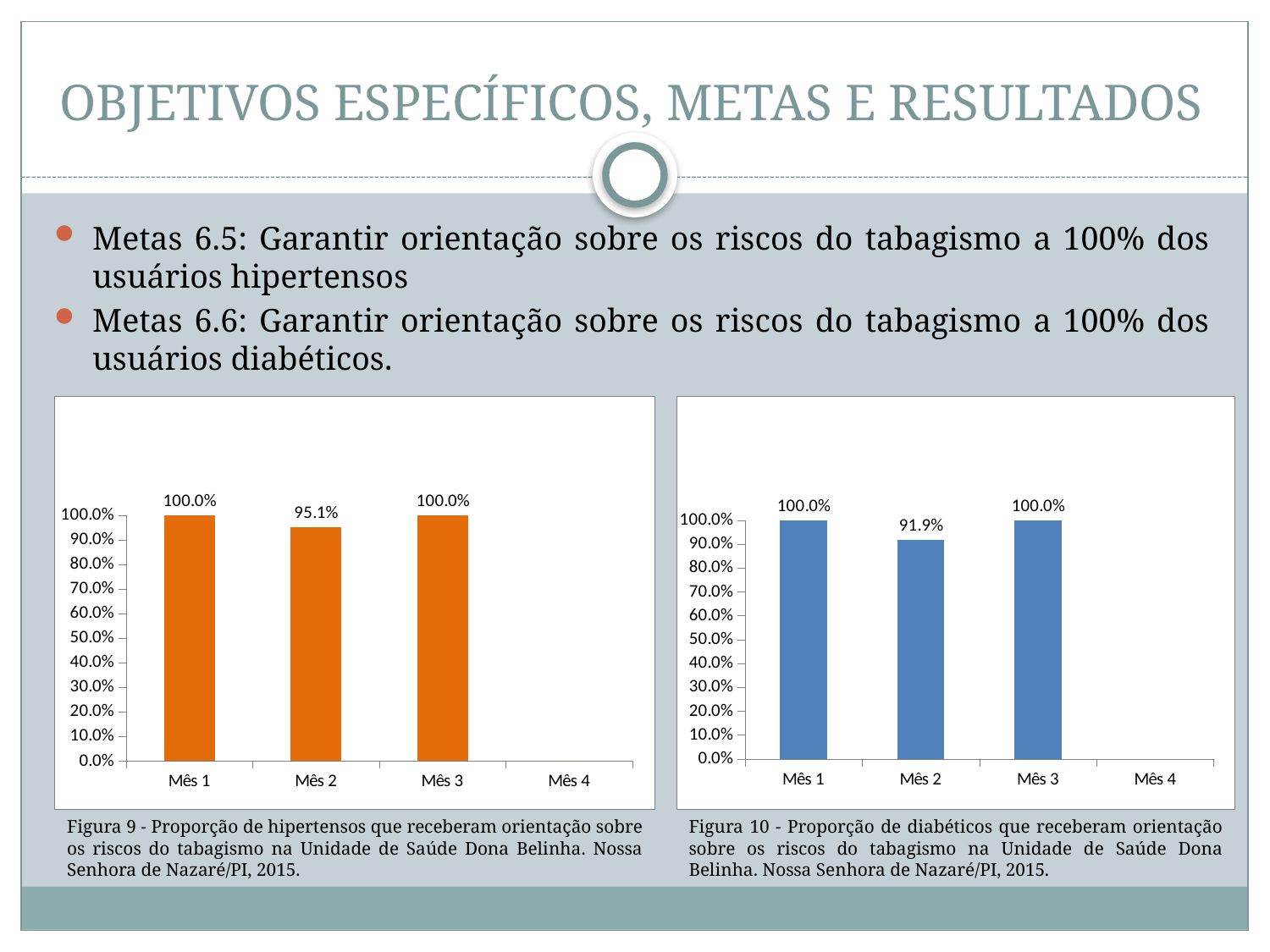
In the right chart (Figura 10), among the months with a bar, which month has the lowest value? Mês 2 In the left chart (Figura 9), what is the value for Mês 1? 100.0% In the right chart (Figura 10), what is the value for Mês 2? 91.9% What type of chart is the right chart (Figura 10)? Bar chart In the right chart (Figura 10), what is the value for Mês 3? 100.0% Which is larger: the Mês 2 value in the left chart (Figura 9) or the Mês 2 value in the right chart (Figura 10)? Left chart (Figura 9), 95.1% In the left chart (Figura 9), what is the value for Mês 2? 95.1% In the left chart (Figura 9), among the months with a bar, which month has the lowest value? Mês 2 In the right chart (Figura 10), what is the difference between the values for Mês 3 and Mês 2? 8.1% In the right chart (Figura 10), is the value for Mês 2 greater or less than 90.0%? greater How many categories are shown on the x axis of the left chart (Figura 9)? 4 In the left chart (Figura 9), what is the difference between the values for Mês 1 and Mês 2? 4.9%